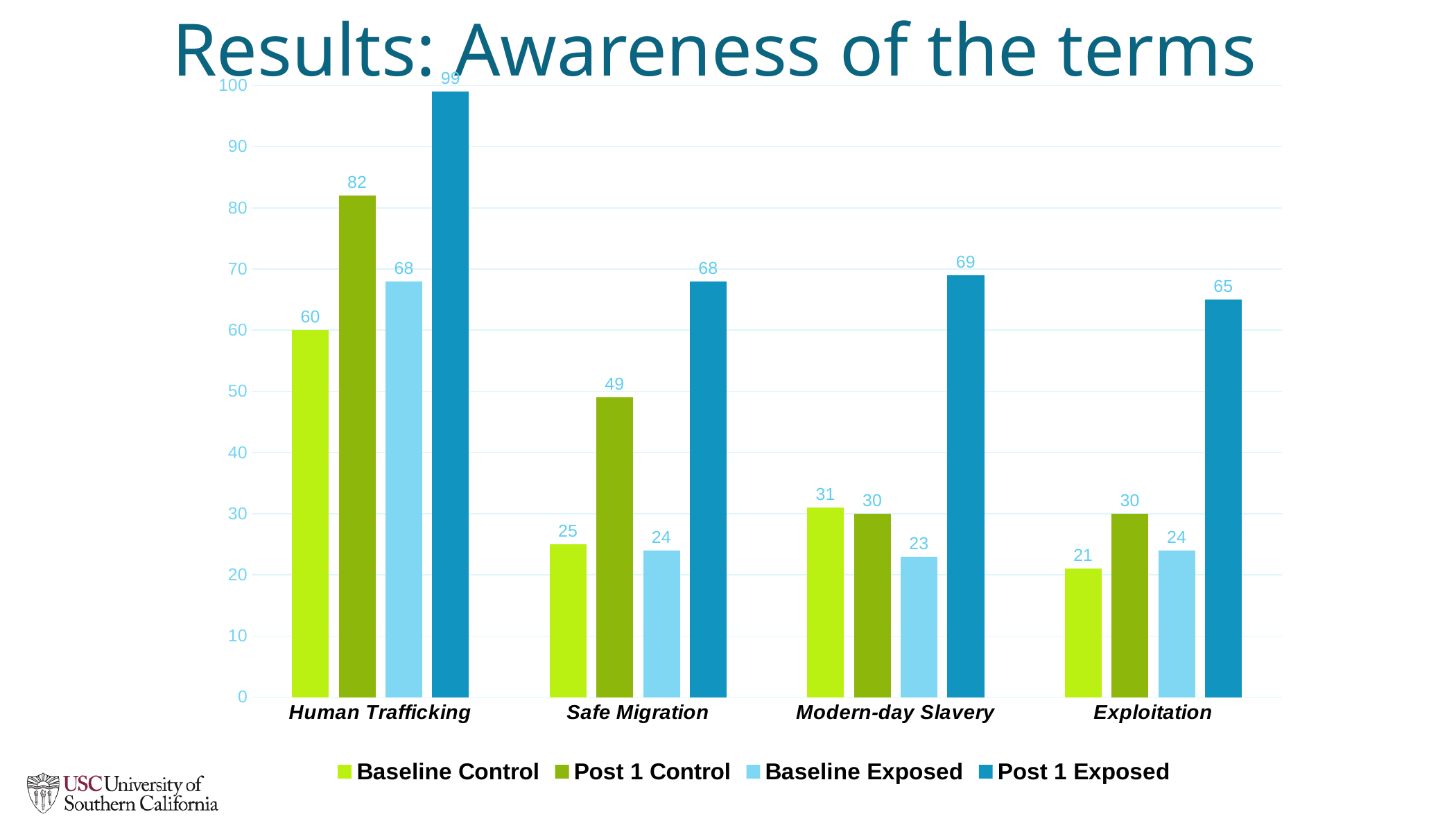
How many series does the legend list? 4 Which is larger for Modern-day Slavery: Baseline Control or Baseline Exposed? Baseline Control What is the difference between the Post 1 Control and Baseline Control values for Human Trafficking? 22 What is the title of the slide? Results: Awareness of the terms Which category has the lowest Baseline Control value? Exploitation What is the Baseline Control value for Exploitation? 21 How many categories are shown on the x axis? 4 What is the Post 1 Control value for Safe Migration? 49 What kind of chart is shown on the slide? bar chart What is the Post 1 Exposed value for Human Trafficking? 99 Is the Post 1 Exposed value for Exploitation greater or less than 60? greater Which category has the highest Post 1 Exposed value? Human Trafficking